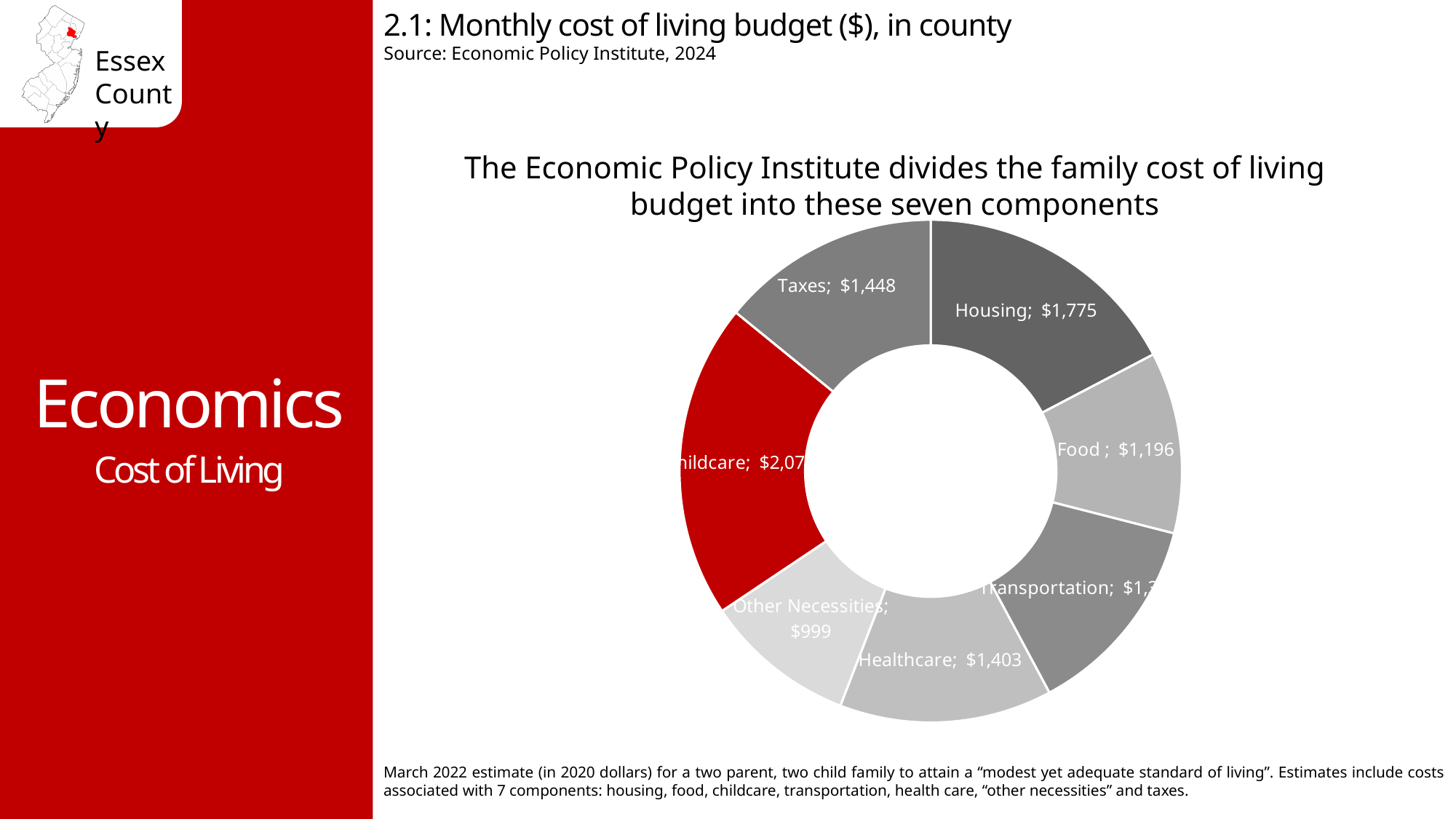
Which is larger, the Healthcare cost or the Food cost? Healthcare How much higher is the Housing cost than the Taxes cost? $327 What is the monthly Taxes value shown in the chart? $1,448 What is the monthly Food cost shown in the chart? $1,196 What is the monthly Other Necessities cost shown in the chart? $999 What is the monthly Housing cost shown in the chart? $1,775 Which component has the largest share of the monthly cost of living budget? Childcare Which component's slice is coloured red in the chart? Childcare What is the monthly Healthcare cost shown in the chart? $1,403 What type of chart is used on this slide? Doughnut (pie) chart How many components does the chart divide the cost of living budget into? 7 Which component has the smallest monthly cost in the chart? Other Necessities